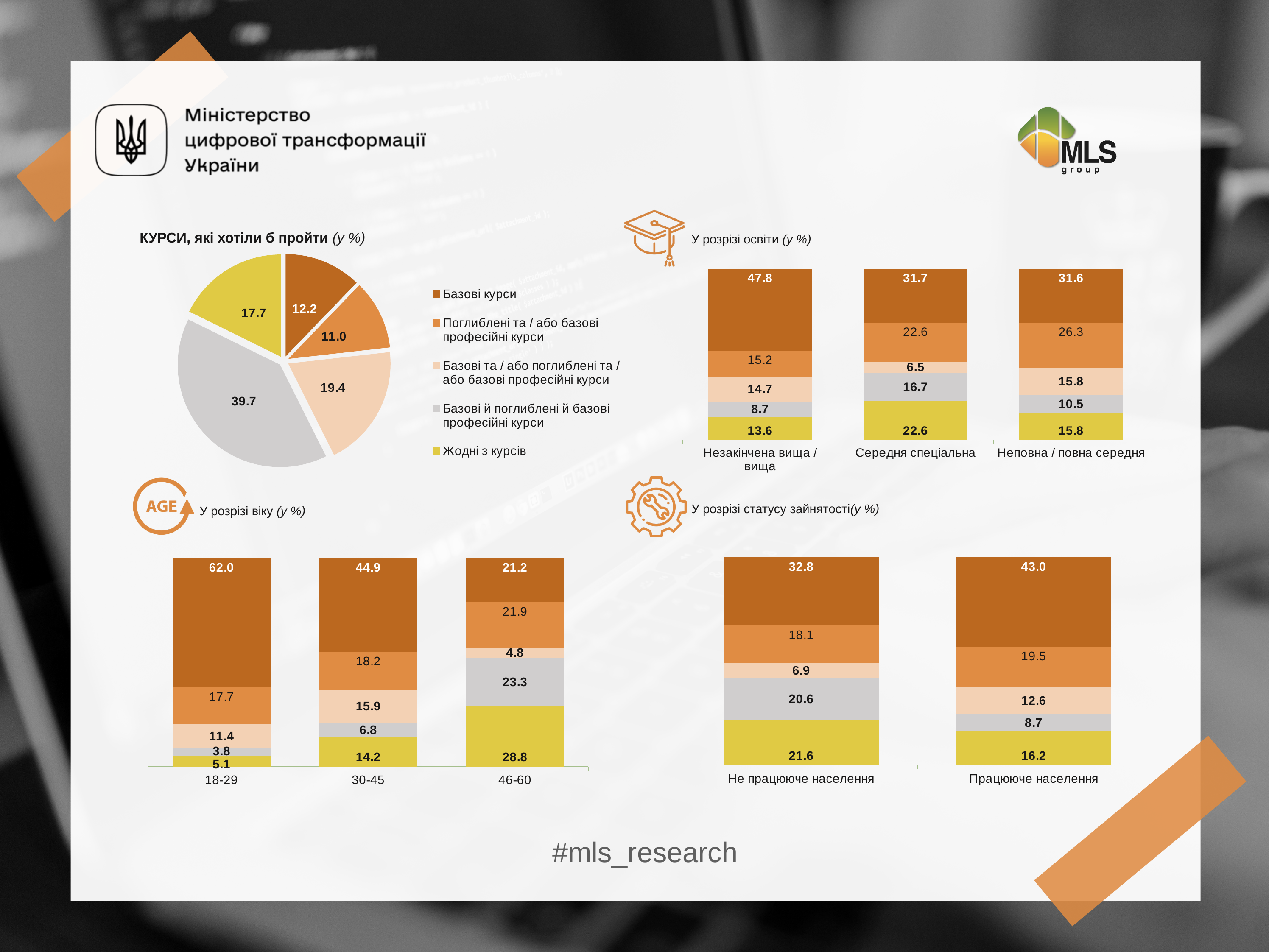
In the chart 'У розрізі віку', what is the difference between the 'Базові курси' values for 18-29 and 30-45? 17.1 In the pie chart 'КУРСИ, які хотіли б пройти', which category has the smallest slice? Поглиблені та / або базові професійні курси In the chart 'У розрізі статусу зайнятості', which group has the larger 'Жодні з курсів' value, 'Не працююче населення' or 'Працююче населення'? Не працююче населення In the chart 'У розрізі освіти', which education group has the highest 'Базові курси' value? Незакінчена вища / вища What kind of chart is 'У розрізі статусу зайнятості'? stacked bar chart In the chart 'У розрізі освіти', what is the value of the 'Жодні з курсів' segment for 'Середня спеціальна'? 22.6 In the chart 'У розрізі віку', does the 'Базові курси' value rise or fall from the 18-29 group to the 46-60 group? fall In the chart 'У розрізі статусу зайнятості', what is the value of the 'Базові курси' segment for 'Працююче населення'? 43.0 In the pie chart 'КУРСИ, які хотіли б пройти', how many slices are there? 5 In the chart 'У розрізі віку', what is the value of the 'Жодні з курсів' segment for the 46-60 age group? 28.8 In the pie chart 'КУРСИ, які хотіли б пройти', what is the value for 'Базові й поглиблені й базові професійні курси'? 39.7 In the chart 'У розрізі освіти', what is the value of the 'Базові курси' segment for 'Незакінчена вища / вища'? 47.8